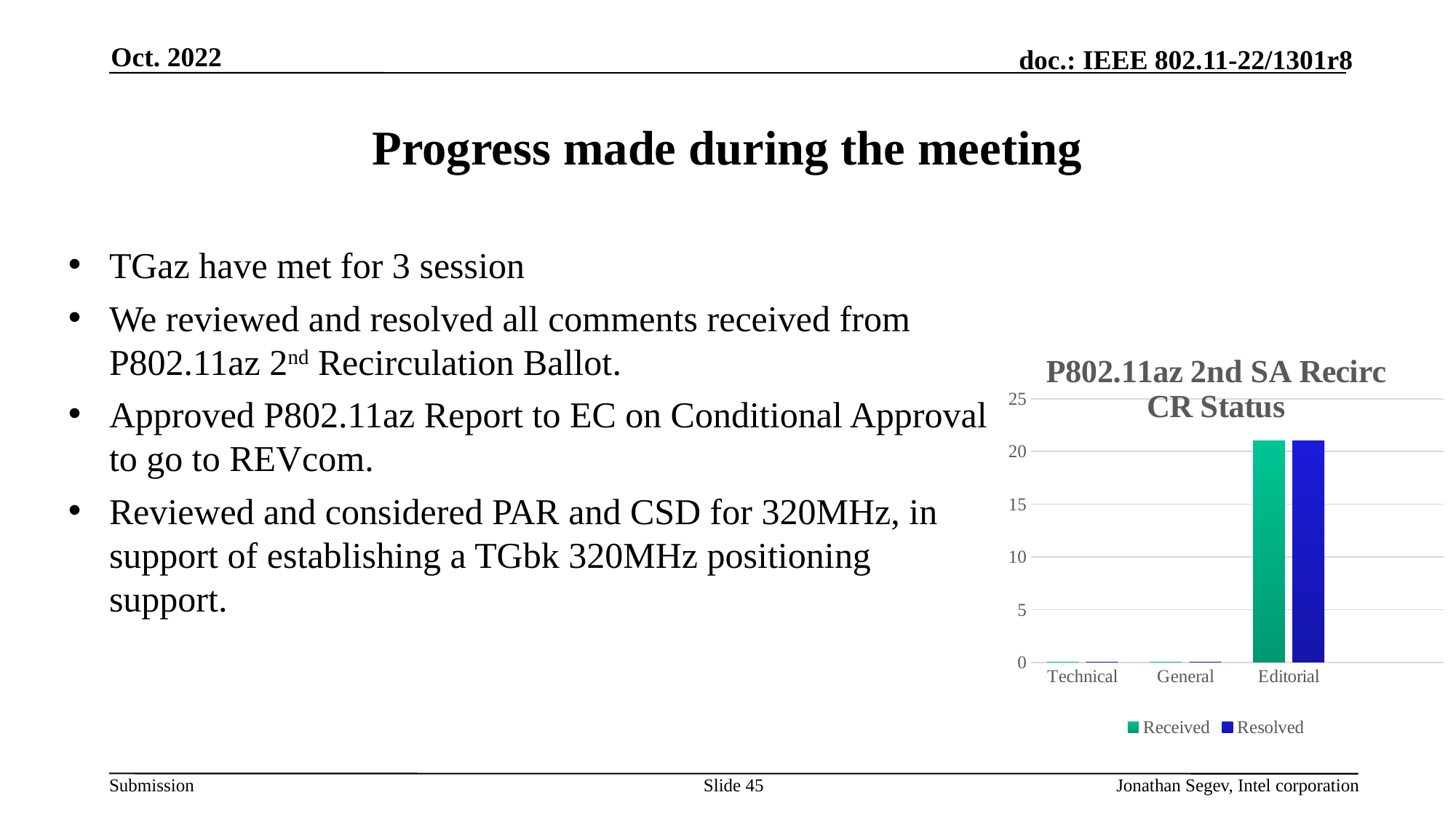
Which category has the highest Resolved value? Editorial Is the Resolved value for General greater or less than 5? less Which is larger, the Received value for Editorial or the Received value for Technical? Editorial What is the title of the chart on the slide? P802.11az 2nd SA Recirc CR Status Is the Resolved value for Editorial greater or less than 25? less How many categories are shown on the x axis of the chart? 3 What type of chart is shown on the slide? bar chart Which series is shown in blue in the chart legend? Resolved How many series does the chart legend list? 2 Is the Received value for Editorial greater or less than 20? greater Which category has the highest Received value? Editorial